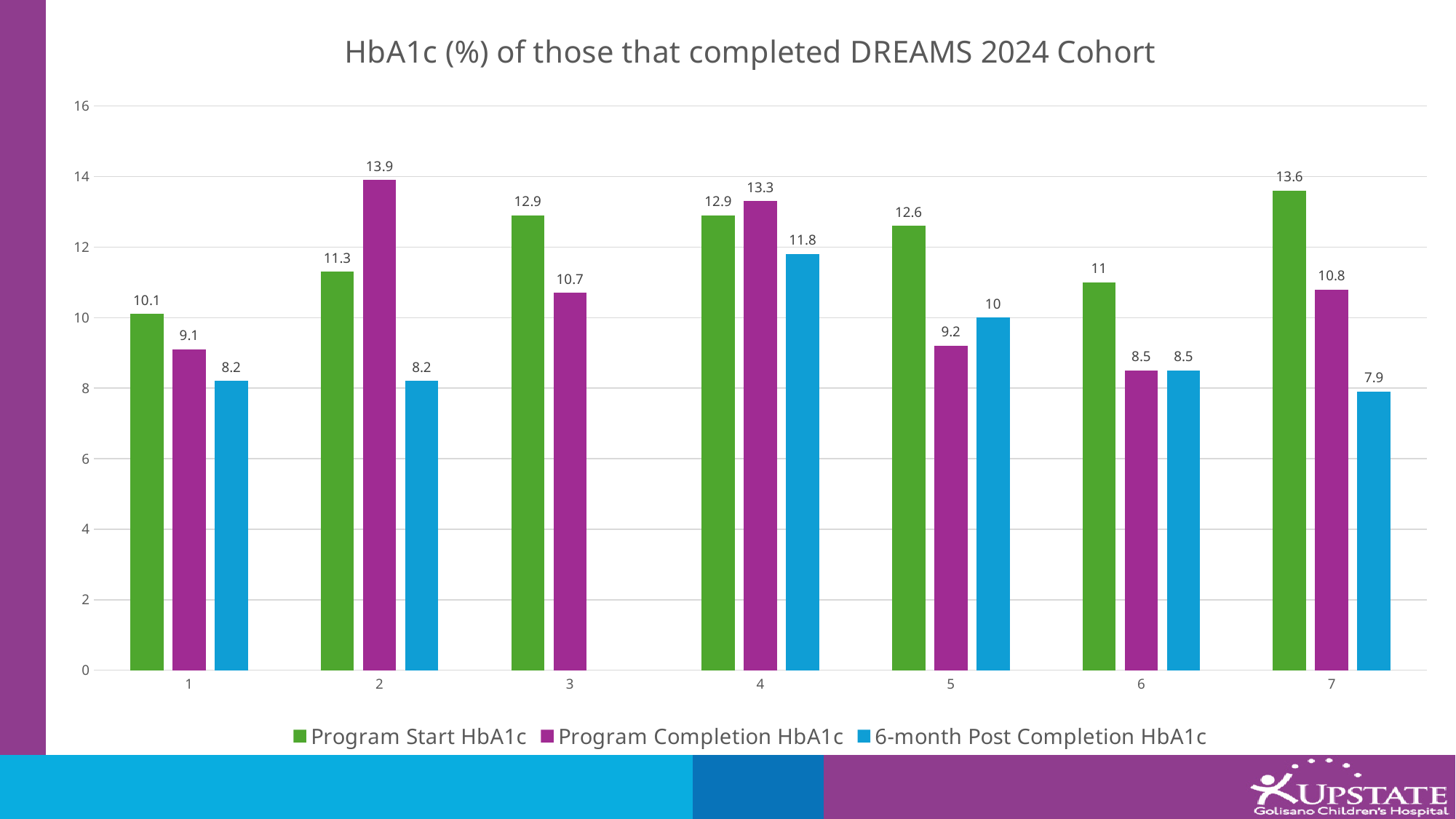
What is the Program Start HbA1c value for participant 1? 10.1 What is the Program Completion HbA1c value for participant 2? 13.9 For participant 5, which is larger: the Program Completion HbA1c or the 6-month Post Completion HbA1c? 6-month Post Completion HbA1c How many participants (categories) are shown on the x axis? 7 What is the 6-month Post Completion HbA1c value for participant 4? 11.8 Which participant has the highest Program Start HbA1c? 7 Which colour represents the Program Completion HbA1c series? Purple What kind of chart is shown on the slide? Bar chart Which participant has the lowest 6-month Post Completion HbA1c? 7 What is the title of the chart? HbA1c (%) of those that completed DREAMS 2024 Cohort How many series does the legend list? 3 What is the difference between the Program Start HbA1c and the 6-month Post Completion HbA1c for participant 7? 5.7